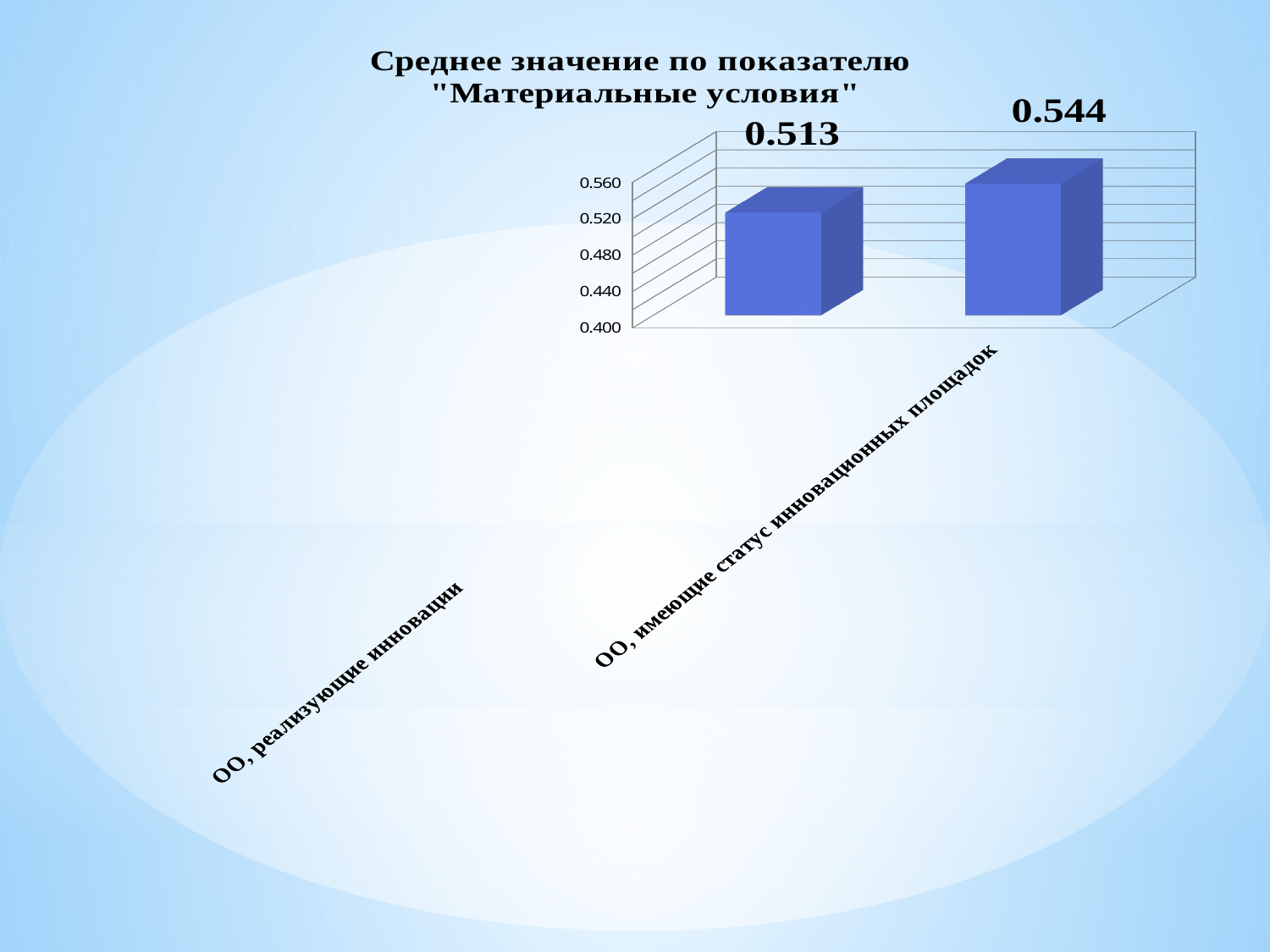
What kind of chart is shown on the slide? Bar chart Which category has the lowest value? ОО, реализующие инновации Which is larger: the value for "ОО, реализующие инновации" or the value for "ОО, имеющие статус инновационных площадок"? ОО, имеющие статус инновационных площадок Which category has the highest value? ОО, имеющие статус инновационных площадок Is the value for "ОО, имеющие статус инновационных площадок" greater or less than 0.520? greater How many categories are shown in the chart? 2 What is the lowest value shown on the vertical axis? 0.400 What is the value for "ОО, реализующие инновации"? 0.513 What is the difference between the values for "ОО, имеющие статус инновационных площадок" and "ОО, реализующие инновации"? 0.031 What is the title of the chart? Среднее значение по показателю "Материальные условия" Is the value for "ОО, реализующие инновации" greater or less than 0.520? less What is the value for "ОО, имеющие статус инновационных площадок"? 0.544